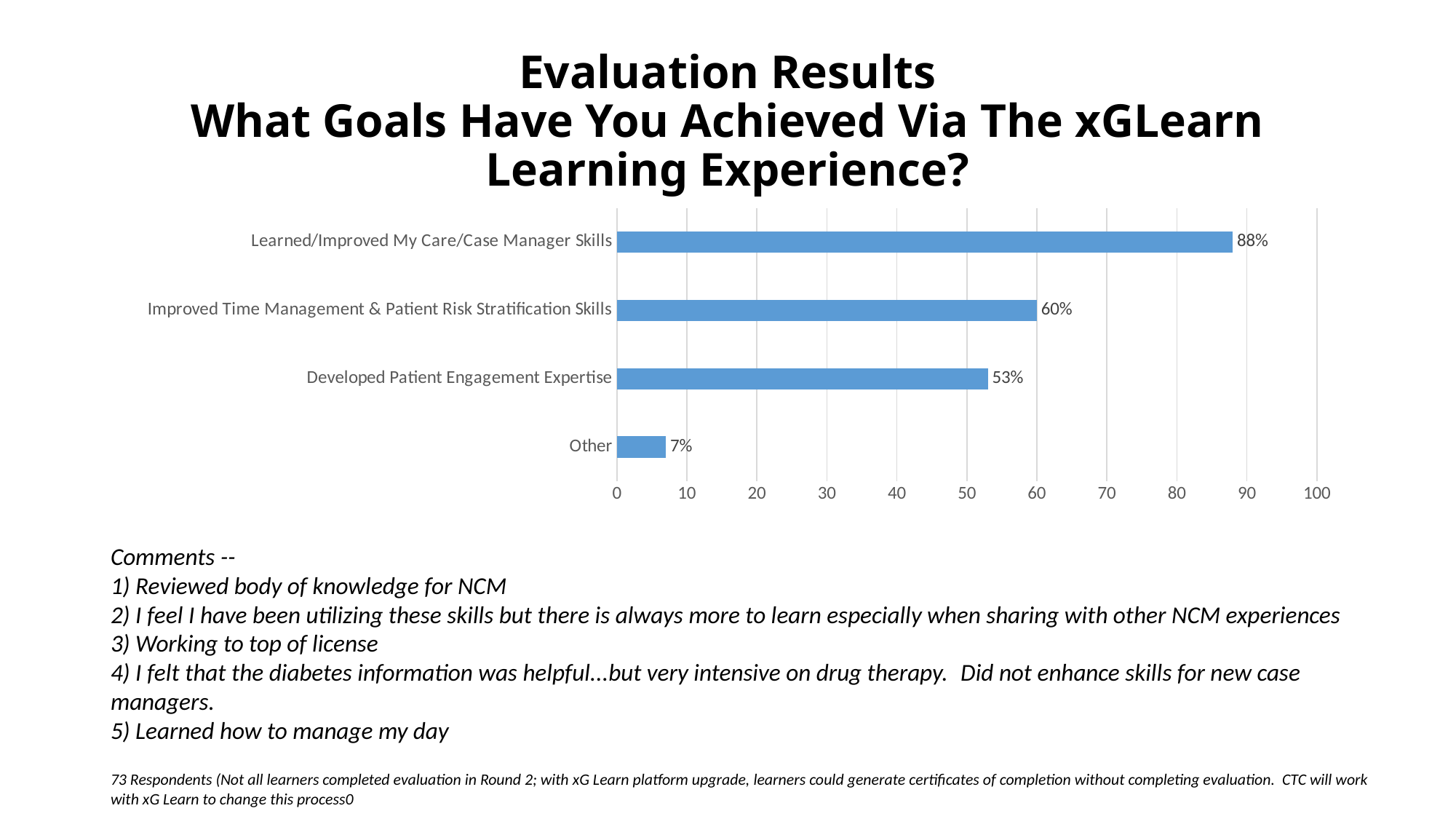
What is the value for Improved Time Management & Patient Risk Stratification Skills? 60% What kind of chart is shown on the slide? Bar chart What is the difference between the values for Improved Time Management & Patient Risk Stratification Skills and Developed Patient Engagement Expertise? 7% What is the value for Developed Patient Engagement Expertise? 53% Which is larger: the value for Developed Patient Engagement Expertise or the value for Other? Developed Patient Engagement Expertise What percentage of respondents reported they Learned/Improved My Care/Case Manager Skills? 88% Which category has the lowest value? Other What is the value for the Other category? 7% How many categories are shown in the chart? 4 Which goal has the highest percentage of respondents? Learned/Improved My Care/Case Manager Skills What is the maximum value shown on the horizontal axis? 100 What is the difference between the values for Learned/Improved My Care/Case Manager Skills and Improved Time Management & Patient Risk Stratification Skills? 28%